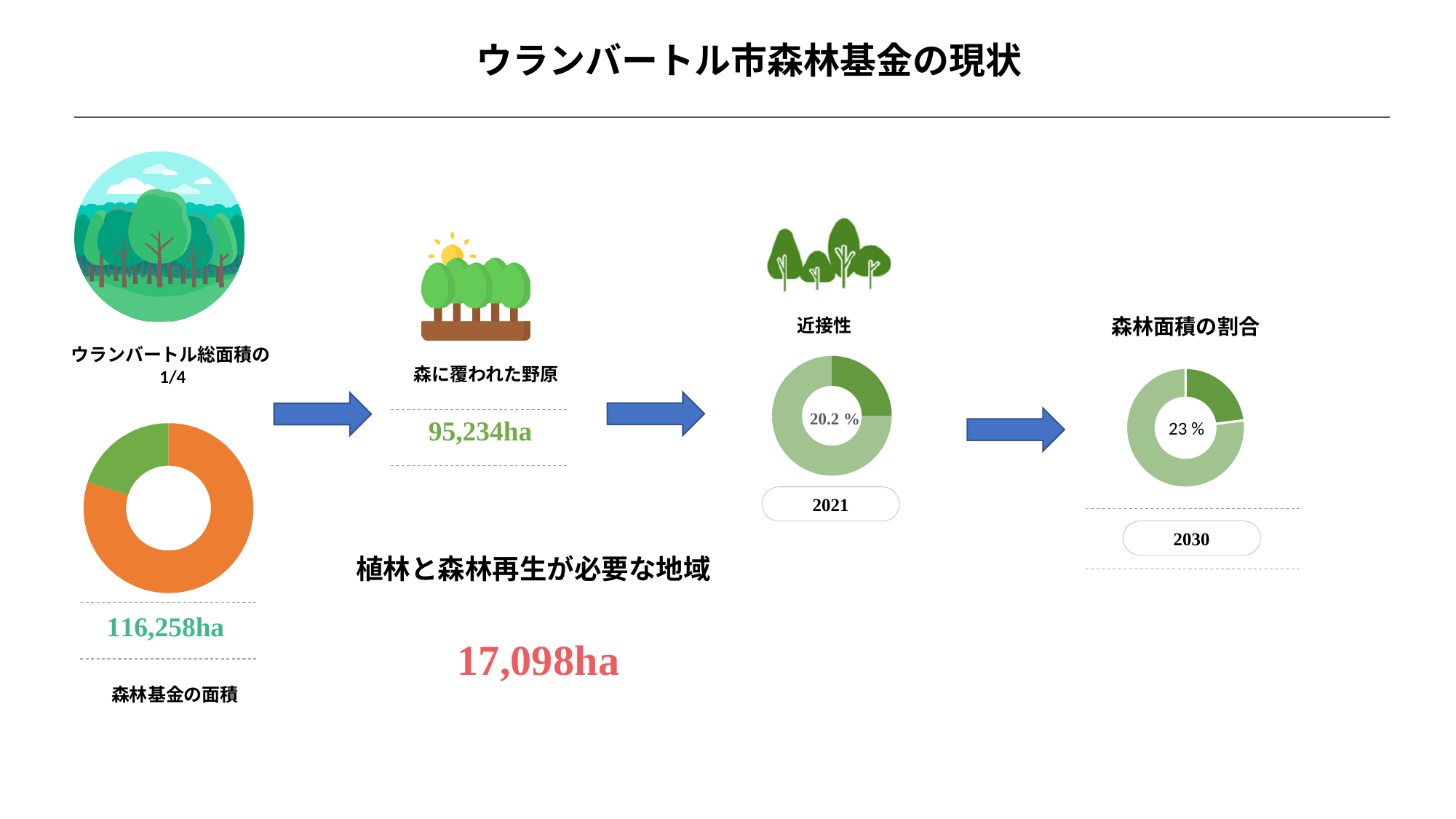
Which year is shown beneath the 近接性 donut chart? 2021 What area value is printed below the orange-and-green donut chart on the left? 116,258ha In the 森林面積の割合 donut chart, what percentage is printed in the centre? 23 % Which is larger: the percentage in the 近接性 chart (2021) or the percentage in the 森林面積の割合 chart (2030)? 森林面積の割合 (23 %) In the orange-and-green donut chart on the left (森林基金の面積), which colour slice is larger? Orange What is the difference between the 23 % in the 森林面積の割合 chart and the 20.2 % in the 近接性 chart? 2.8 percentage points How many slices does the orange-and-green donut chart on the left have? 2 In the 近接性 donut chart, is the dark green slice greater or less than half of the ring? less How many donut charts are on the slide? 3 In the 近接性 donut chart, what percentage is printed in the centre? 20.2 % What kind of chart is shown under the label 近接性? Donut (pie) chart Which year is shown beneath the 森林面積の割合 donut chart? 2030